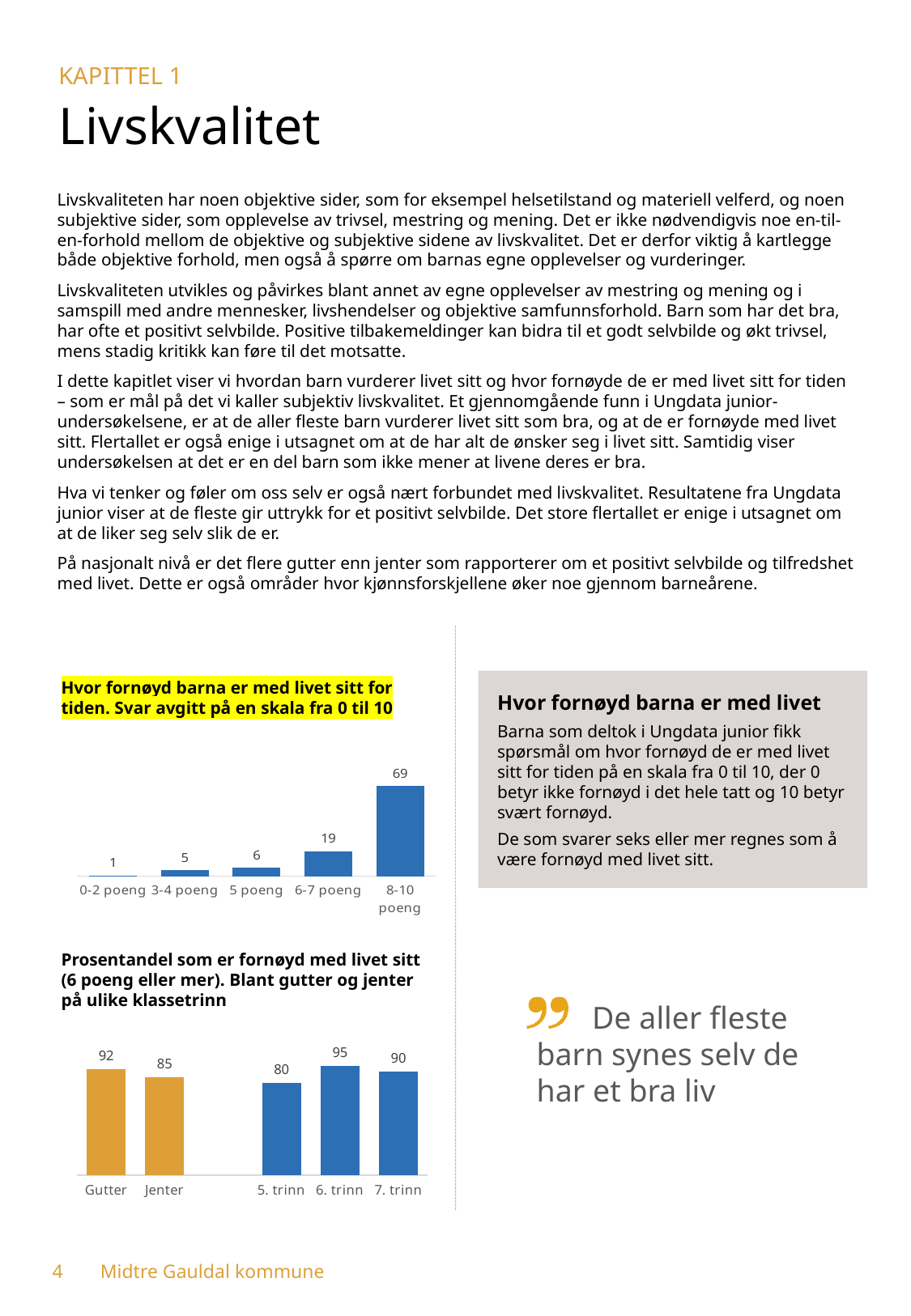
In the top chart 'Hvor fornøyd barna er med livet sitt for tiden', do the values rise or fall from left to right along the x axis? rise In the bottom chart 'Prosentandel som er fornøyd med livet sitt', which is larger, the value for Gutter or the value for Jenter? Gutter In the bottom chart 'Prosentandel som er fornøyd med livet sitt', which category has the highest value? 6. trinn In the bottom chart 'Prosentandel som er fornøyd med livet sitt', what is the difference between the values for 6. trinn and 5. trinn? 15 In the bottom chart 'Prosentandel som er fornøyd med livet sitt', what is the value for 5. trinn? 80 In the bottom chart 'Prosentandel som er fornøyd med livet sitt', what is the value for Gutter? 92 In the top chart 'Hvor fornøyd barna er med livet sitt for tiden', what is the value for 6-7 poeng? 19 In the top chart 'Hvor fornøyd barna er med livet sitt for tiden', what is the value for 8-10 poeng? 69 In the top chart 'Hvor fornøyd barna er med livet sitt for tiden', how many categories are shown on the x axis? 5 In the top chart 'Hvor fornøyd barna er med livet sitt for tiden', which category has the lowest value? 0-2 poeng In the top chart 'Hvor fornøyd barna er med livet sitt for tiden', what is the difference between the values for 8-10 poeng and 6-7 poeng? 50 What type of chart is the bottom chart 'Prosentandel som er fornøyd med livet sitt'? bar chart